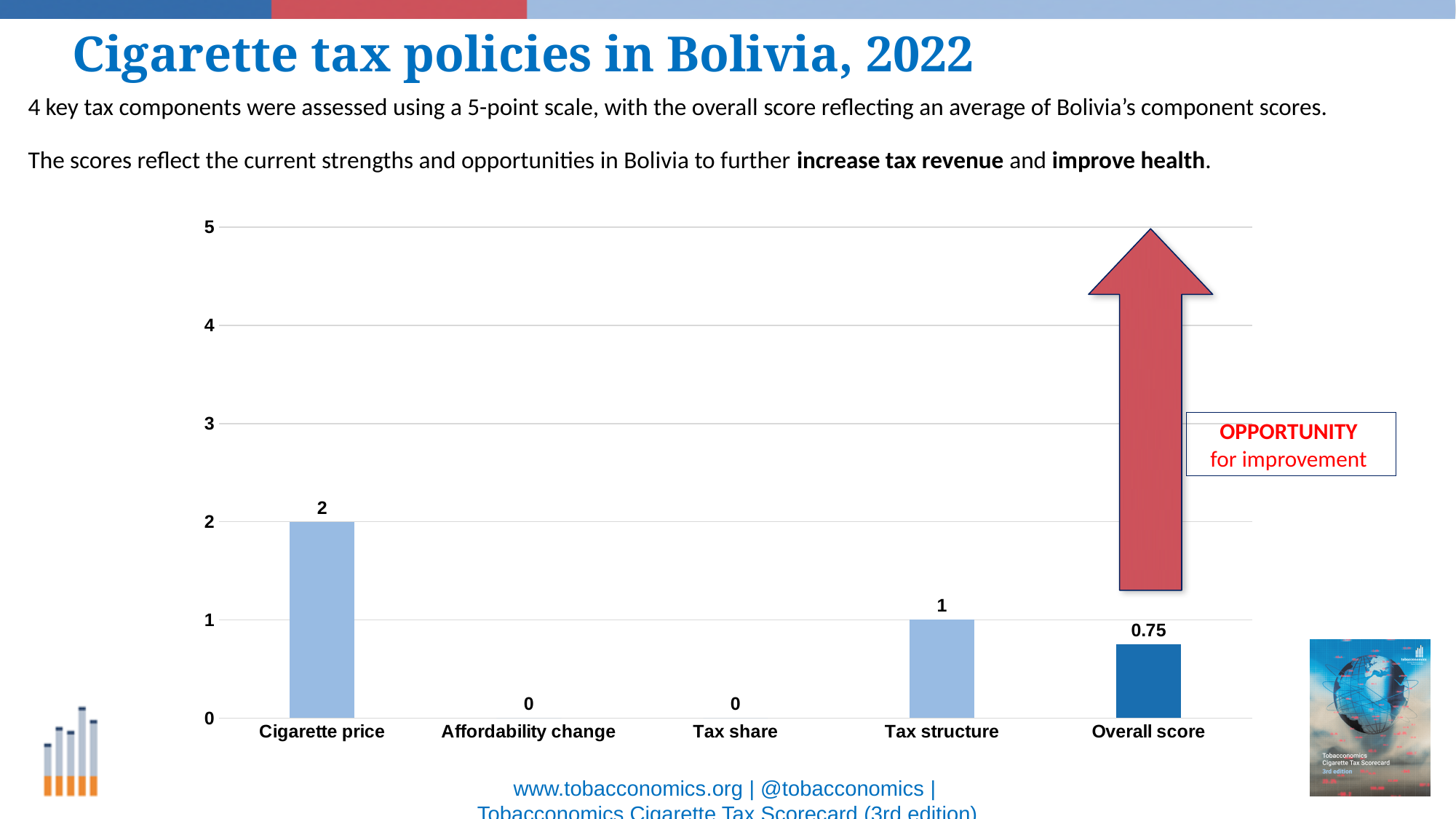
Is the value for Cigarette price greater or less than 3? less How many categories are shown on the x axis? 5 What is the maximum value shown on the y axis? 5 Which is larger, the value for Tax structure or the Overall score? Tax structure What is the value for Tax structure? 1 What is the value for Affordability change? 0 What is the value for Cigarette price? 2 How many categories have a value of 0? 2 What is the Overall score? 0.75 Which category has the highest value? Cigarette price What is the difference between the values for Cigarette price and Tax structure? 1 What kind of chart is shown on the slide? bar chart